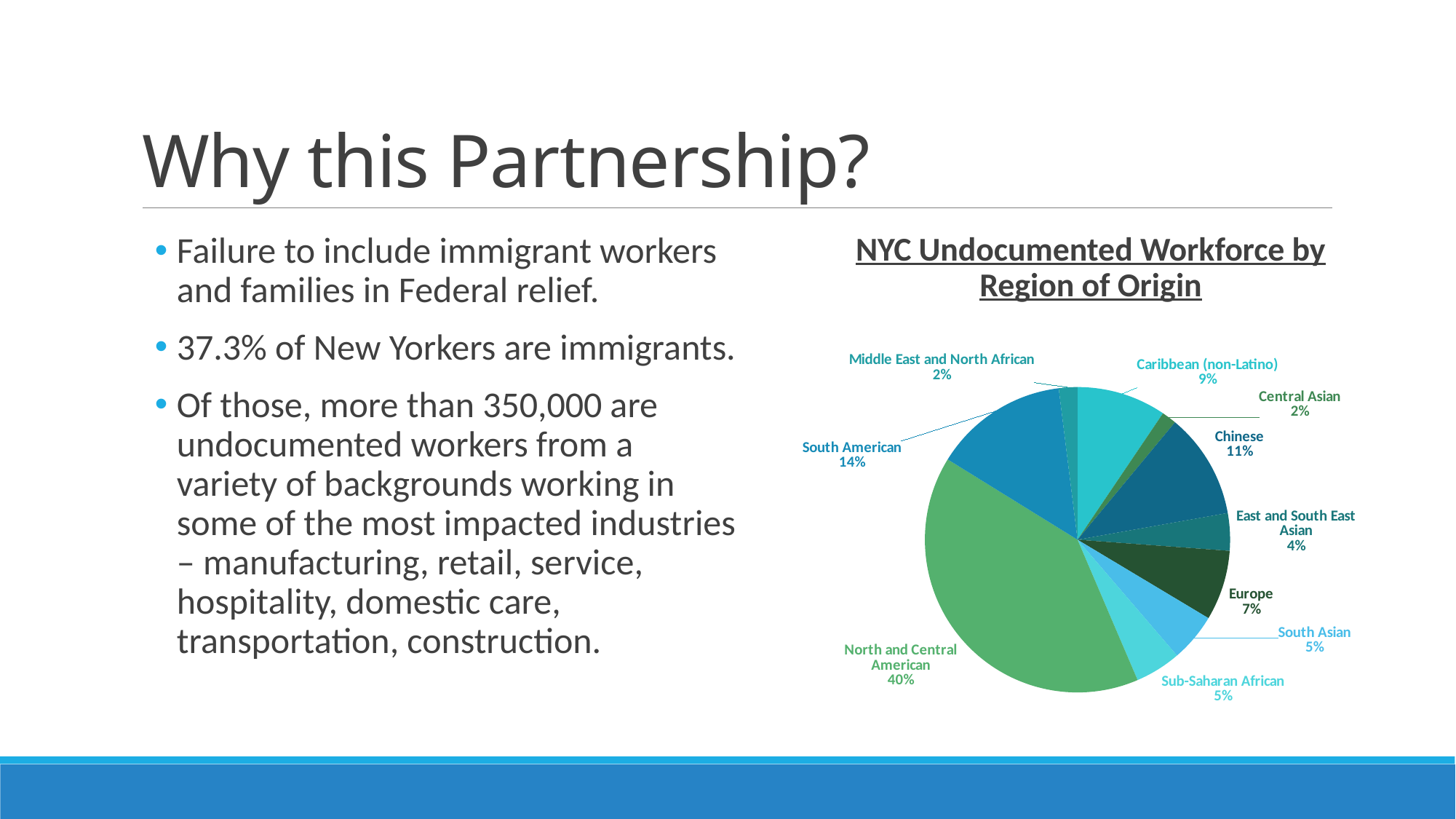
What is the difference in percentage points between the South American and Chinese slices? 3 What percentage is shown for Caribbean (non-Latino)? 9% Which region of origin has the largest slice of the pie? North and Central American What share is shown for South American? 14% What share of the NYC undocumented workforce is North and Central American? 40% What percentage of the pie is labelled Chinese? 11% What percentage is shown for Europe? 7% What is the title of the chart? NYC Undocumented Workforce by Region of Origin Which is larger, the Europe slice or the South Asian slice? Europe What type of chart is shown on the slide? Pie chart How many regions of origin are shown in the pie chart? 10 Which two regions share the smallest percentage of 2%? Middle East and North African and Central Asian